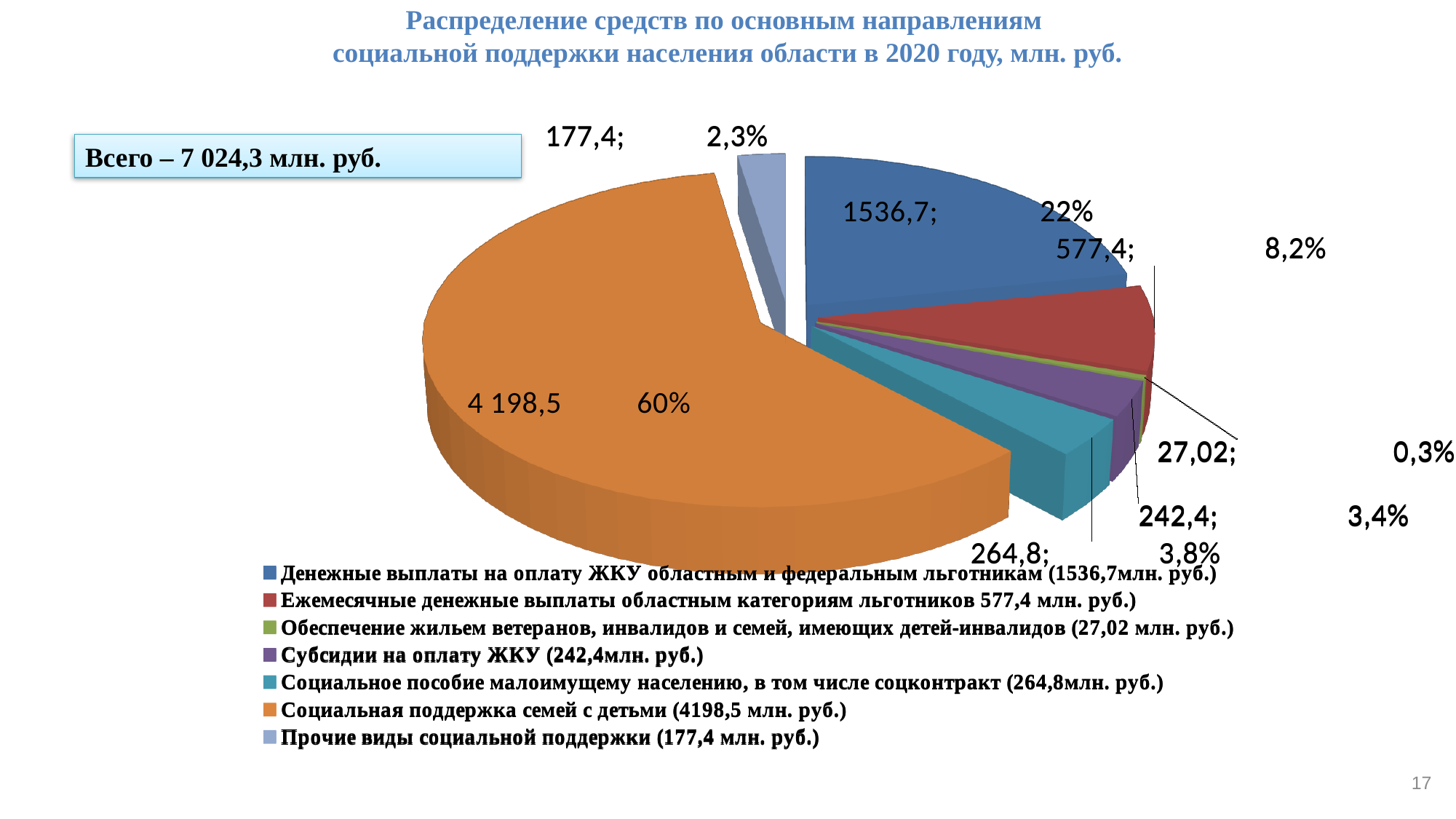
What is the value (млн. руб.) for Ежемесячные денежные выплаты областным категориям льготников? 577,4 What share of the pie is Денежные выплаты на оплату ЖКУ областным и федеральным льготникам? 22% What kind of chart is shown on the slide? Pie chart Which is larger: Социальное пособие малоимущему населению or Субсидии на оплату ЖКУ? Социальное пособие малоимущему населению What total amount (Всего) is stated in the box on the slide? 7 024,3 млн. руб. What share of the pie is Прочие виды социальной поддержки? 2,3% How many slices does the pie chart have? 7 Which category has the smallest slice of the pie? Обеспечение жильем ветеранов, инвалидов и семей, имеющих детей-инвалидов Which category has the largest slice of the pie? Социальная поддержка семей с детьми What is the difference between the values for Денежные выплаты на оплату ЖКУ (1536,7) and Ежемесячные денежные выплаты (577,4)? 959,3 What is the value (млн. руб.) for Субсидии на оплату ЖКУ? 242,4 What share of the pie is Социальная поддержка семей с детьми? 60%